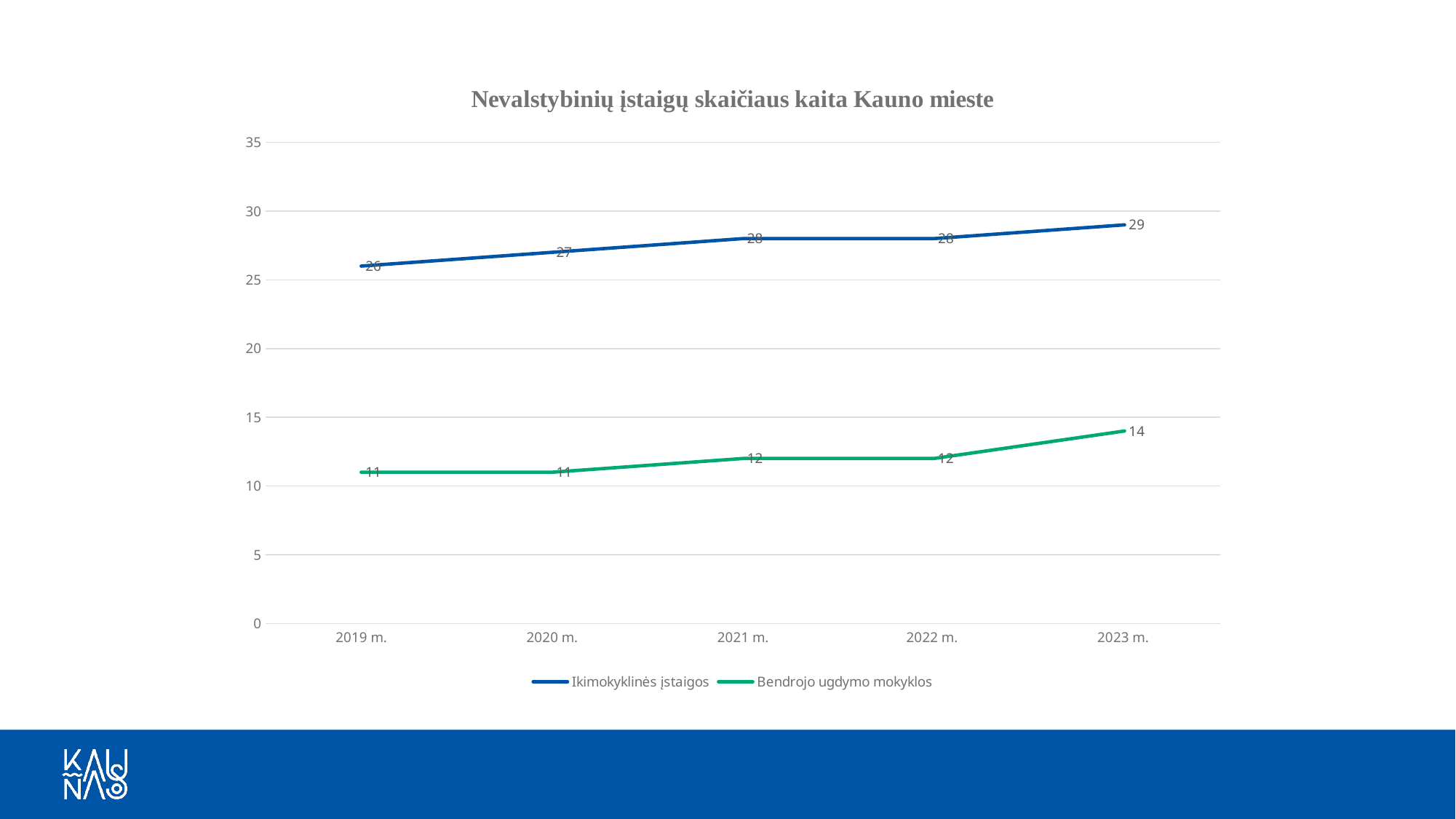
How many series does the legend list? 2 In which year is the value for Bendrojo ugdymo mokyklos highest? 2023 m. What is the value for Ikimokyklinės įstaigos in 2019 m.? 26 By how much did the value for Ikimokyklinės įstaigos change from 2019 m. to 2023 m.? 3 What is the difference between Ikimokyklinės įstaigos and Bendrojo ugdymo mokyklos in 2023 m.? 15 What kind of chart is shown on the slide? Line chart How many years are shown on the x axis? 5 Does the value for Bendrojo ugdymo mokyklos rise or fall from 2019 m. to 2023 m.? Rise In which year is the value for Ikimokyklinės įstaigos highest? 2023 m. What is the value for Bendrojo ugdymo mokyklos in 2023 m.? 14 Which series has the larger value in 2020 m., Ikimokyklinės įstaigos or Bendrojo ugdymo mokyklos? Ikimokyklinės įstaigos What is the value for Ikimokyklinės įstaigos in 2021 m.? 28